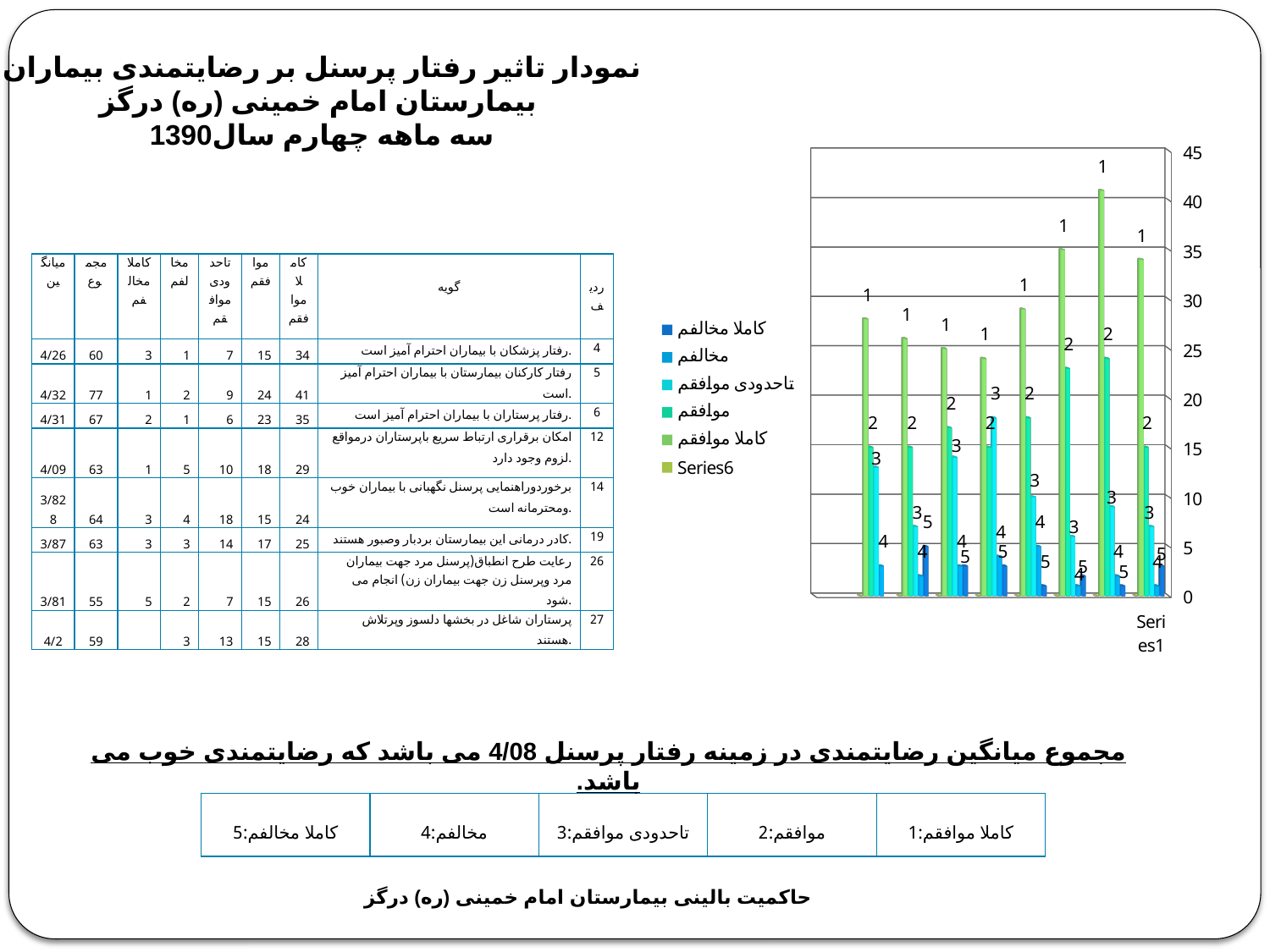
In the first group from the left, which is taller: the bar for کاملا موافقم or the bar for کاملا مخالفم? کاملا موافقم Is the tallest bar in the rightmost group greater or less than 30? greater Which group of bars contains the tallest bar in the chart? the seventh group from the left Is the tallest bar in the first group from the left greater or less than 25? greater How many series does the chart's legend list? 6 What is the last entry in the chart's legend? Series6 Is the tallest bar in the seventh group from the left greater or less than 35? greater What kind of chart is shown on the right side of the slide? bar chart How many groups of bars are plotted in the chart? 8 What label is shown on the chart's horizontal axis? Series1